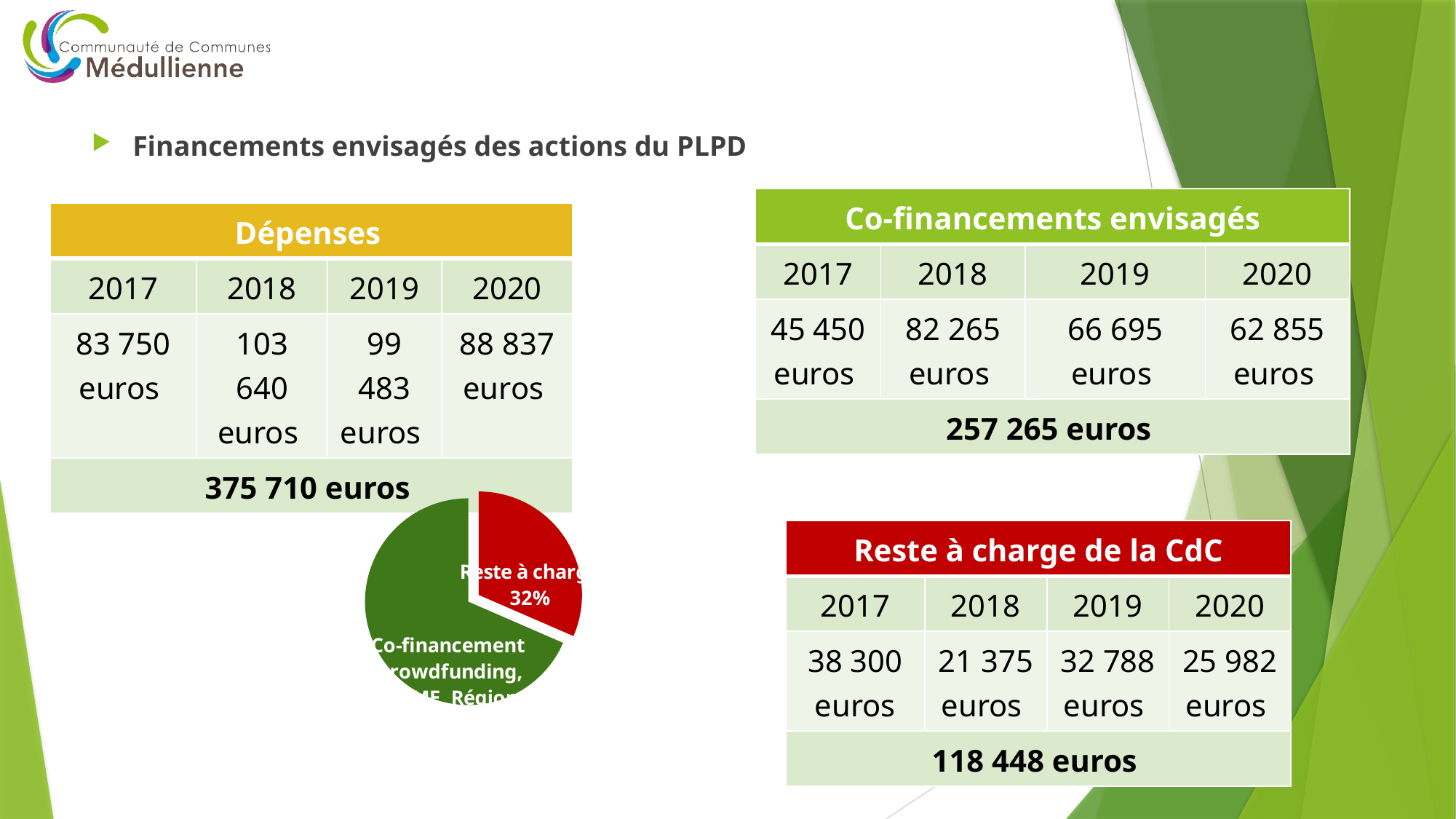
What colour is the 'Reste à charge' slice in the pie chart? red What colour is the 'Co-financement' slice in the pie chart? green What share of the pie chart does the 'Reste à charge' slice represent? 32% What kind of chart is shown on the slide? pie chart Which slice of the pie chart is the largest? Co-financement In the pie chart, which is larger: the 'Reste à charge' slice or the 'Co-financement' slice? Co-financement Is the 'Reste à charge' slice greater or less than 50% of the pie chart? less Which slice of the pie chart is the smallest? Reste à charge How many slices does the pie chart have? 2